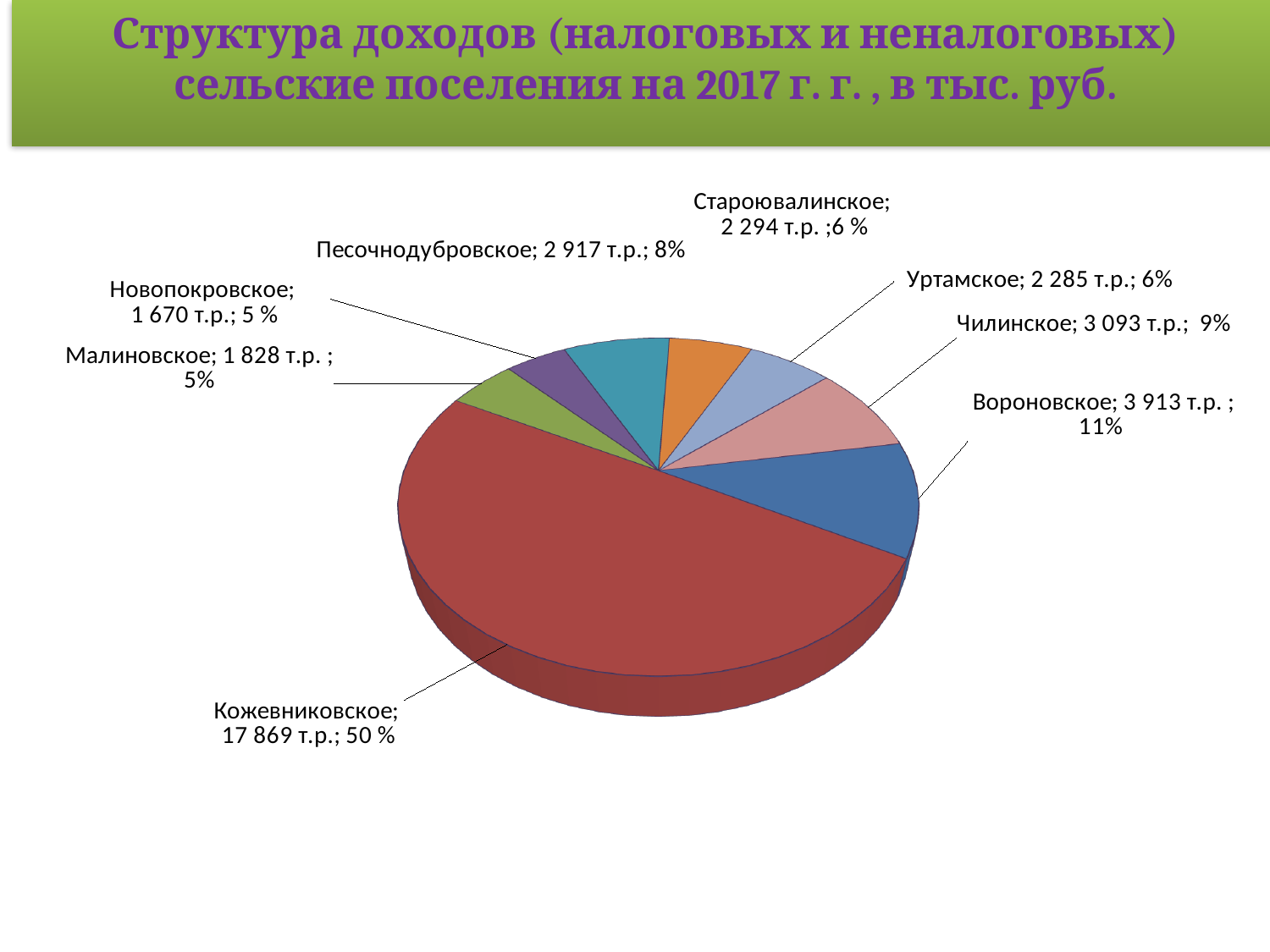
What is the value for Вороновское? 3 913 т.р. What type of chart is shown on the slide? pie chart What is the difference between the values for Вороновское and Чилинское? 820 т.р. What is the value for Новопокровское? 1 670 т.р. How many slices does the pie chart have? 8 What share of the pie does Песочнодубровское account for? 8% What colour is the Кожевниковское slice? red Which settlement has the smallest income value? Новопокровское What is the value for Кожевниковское? 17 869 т.р. Which settlement has the largest share of income? Кожевниковское What share of the pie does Чилинское account for? 9% Which is larger, the value for Песочнодубровское or Малиновское? Песочнодубровское